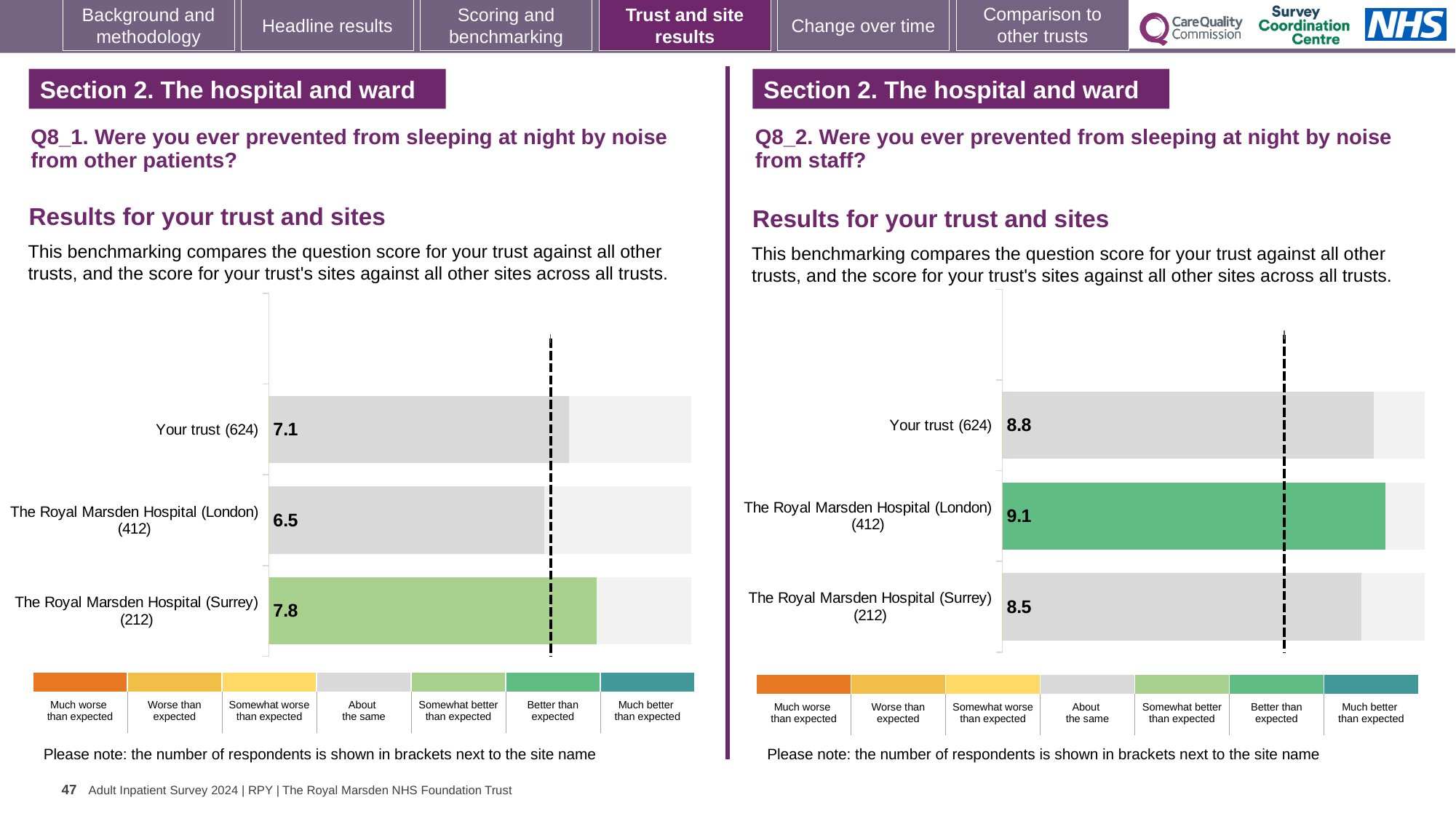
On the Q8_2 chart (noise from staff), which is larger: the score for the London site or the score for Your trust? The Royal Marsden Hospital (London) (412) What type of chart is used on the Q8_1 chart (noise from other patients)? Bar chart On the Q8_1 chart (noise from other patients), what is the score for Your trust (624)? 7.1 On the Q8_2 chart (noise from staff), what is the difference between the London site score and Your trust score? 0.3 On the Q8_2 chart (noise from staff), which benchmark category does the colour of the London site bar correspond to in the legend? Better than expected On the Q8_1 chart (noise from other patients), what is the score for The Royal Marsden Hospital (London) (412)? 6.5 On the Q8_1 chart (noise from other patients), how many bars are plotted? 3 On the Q8_2 chart (noise from staff), what is the score for The Royal Marsden Hospital (Surrey) (212)? 8.5 On the Q8_2 chart (noise from staff), which site or trust has the lowest score? The Royal Marsden Hospital (Surrey) (212) On the Q8_1 chart (noise from other patients), which site or trust has the highest score? The Royal Marsden Hospital (Surrey) (212) On the Q8_1 chart (noise from other patients), what is the difference between the Surrey site score and the London site score? 1.3 On the Q8_2 chart (noise from staff), what is the score for Your trust (624)? 8.8